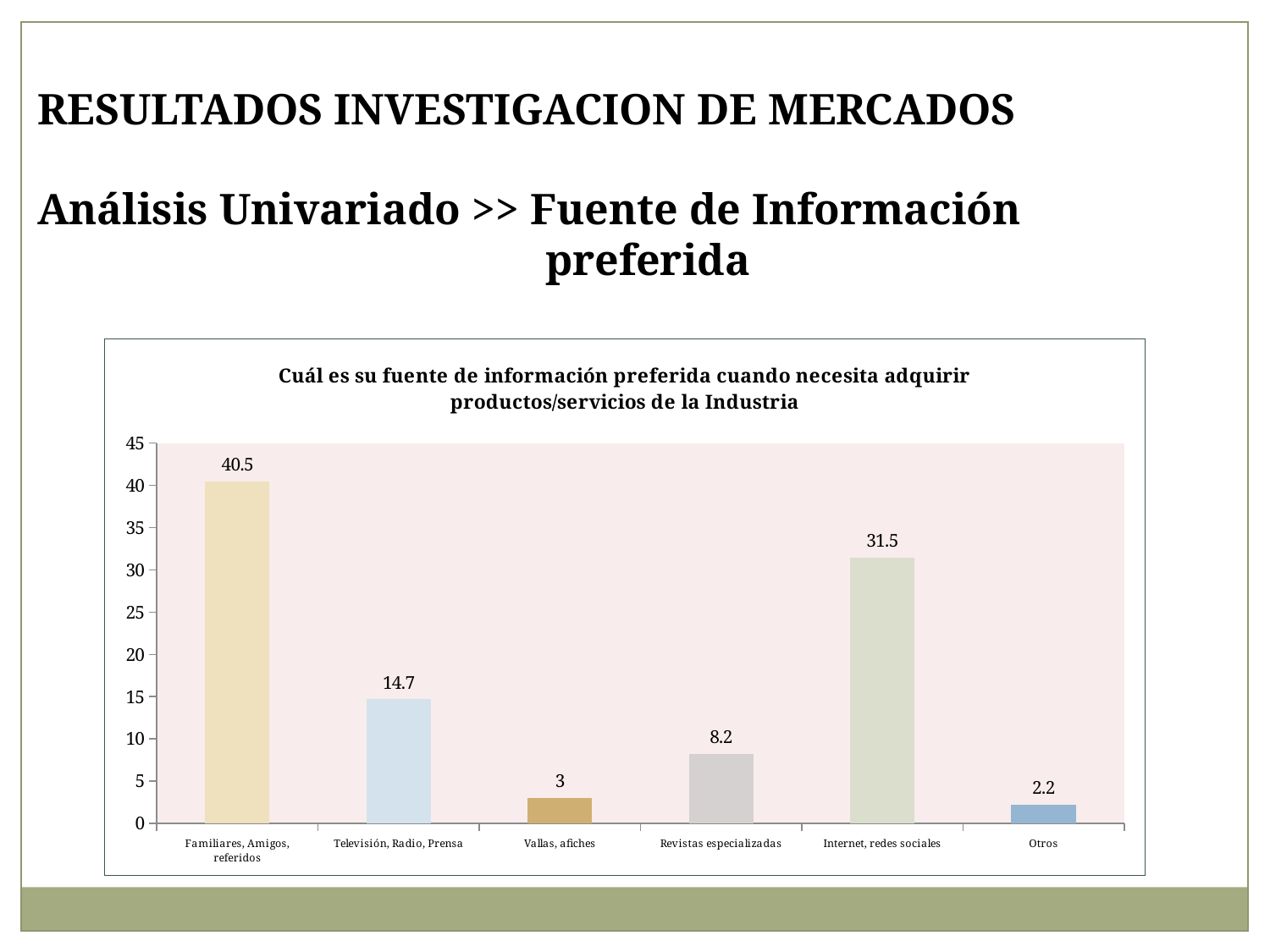
Which category has the highest value? Familiares, Amigos, referidos What is the title of the chart? Cuál es su fuente de información preferida cuando necesita adquirir productos/servicios de la Industria What is the value for Vallas, afiches? 3 What is the value for Familiares, Amigos, referidos? 40.5 What is the value for Internet, redes sociales? 31.5 What is the value for Revistas especializadas? 8.2 Is the value for Televisión, Radio, Prensa greater or less than 20? less How many categories are shown on the x axis? 6 Which category has the lowest value? Otros What is the difference between the values for Familiares, Amigos, referidos and Internet, redes sociales? 9 What kind of chart is shown on the slide? bar chart Which is larger, the value for Televisión, Radio, Prensa or the value for Revistas especializadas? Televisión, Radio, Prensa